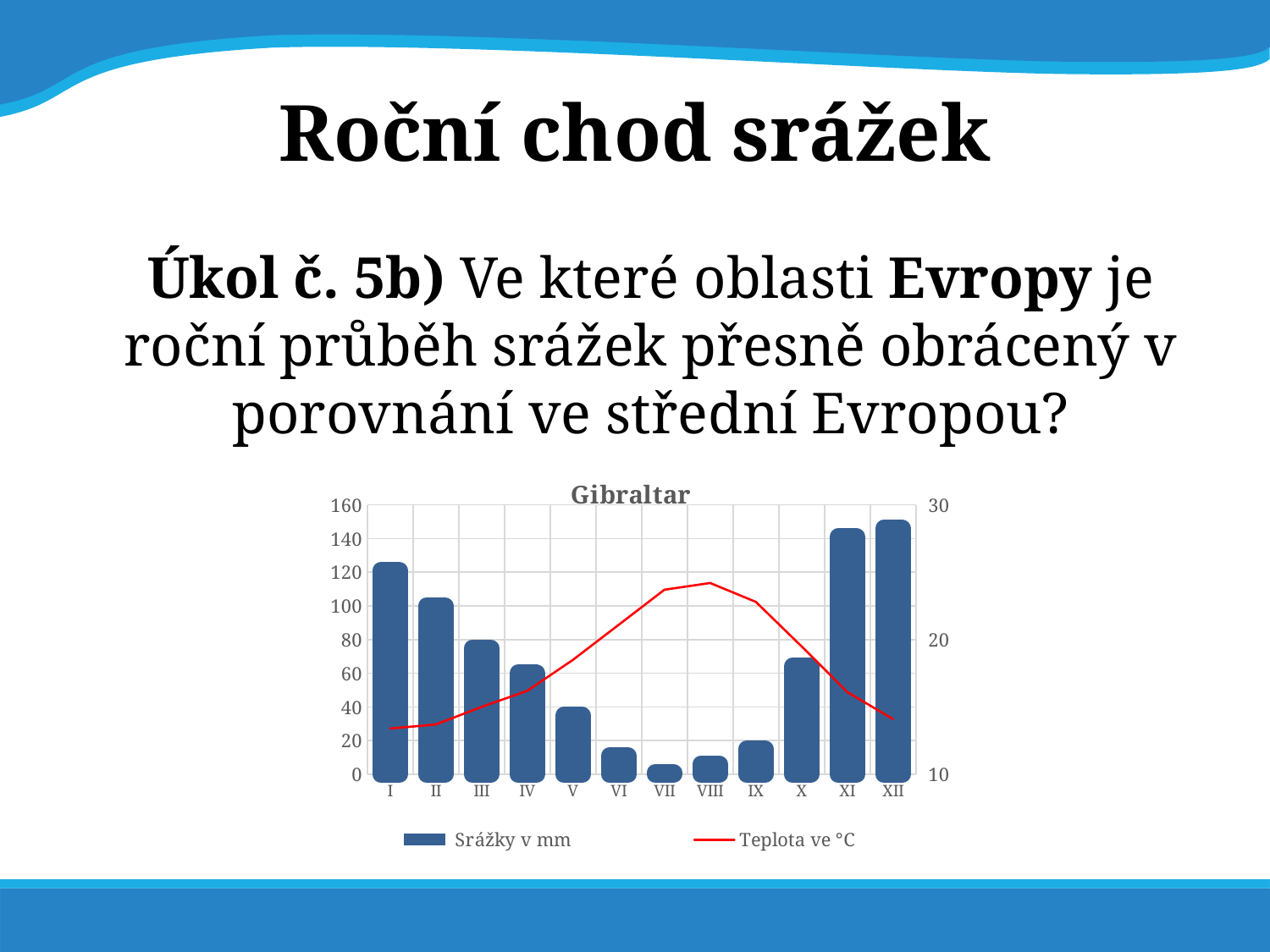
Which month has higher precipitation, VI or IX? IX Is the precipitation value for month VI greater or less than 20? less Which month has the lowest precipitation (Srážky v mm)? VII What kind of chart is shown on the slide? A combined bar and line chart How many series does the legend list? 2 Does the precipitation rise or fall from month I to month VII? fall Which month has higher precipitation, I or II? I What is the title of the chart? Gibraltar Is the temperature (Teplota ve °C) for month VIII greater or less than 20? greater How many months are shown on the x axis? 12